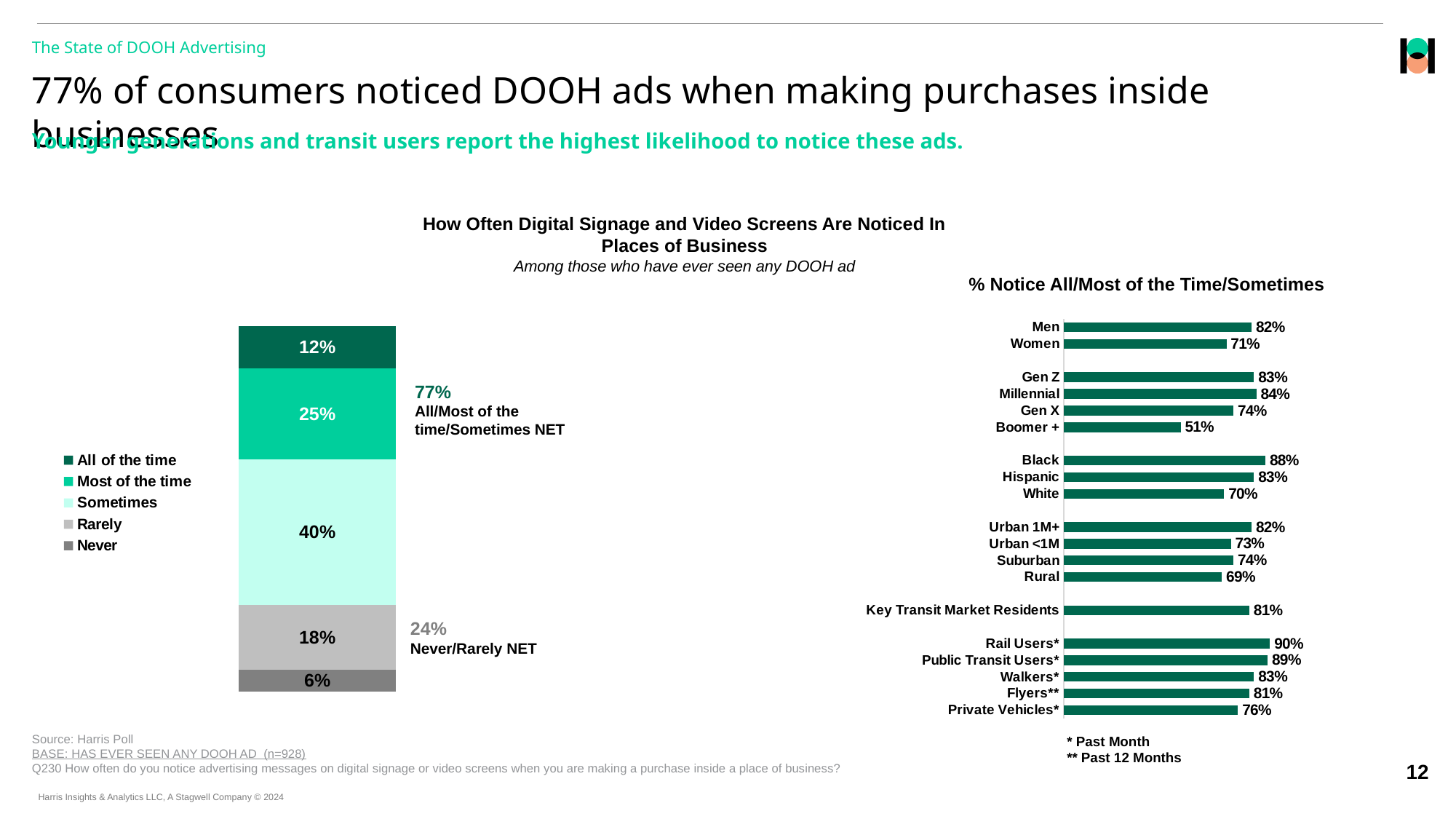
In the '% Notice All/Most of the Time/Sometimes' chart, what is the value for Rail Users*? 90% What kind of chart is the '% Notice All/Most of the Time/Sometimes' chart? Bar chart In the '% Notice All/Most of the Time/Sometimes' chart, what is the difference between Men and Women? 11% In the stacked chart 'How Often Digital Signage and Video Screens Are Noticed In Places of Business', what is the value for Never? 6% In the stacked chart 'How Often Digital Signage and Video Screens Are Noticed In Places of Business', what is the combined total of Rarely and Never? 24% In the '% Notice All/Most of the Time/Sometimes' chart, how many categories are plotted? 19 In the '% Notice All/Most of the Time/Sometimes' chart, which category has the highest value? Rail Users* In the '% Notice All/Most of the Time/Sometimes' chart, which is larger, Urban 1M+ or Rural? Urban 1M+ In the '% Notice All/Most of the Time/Sometimes' chart, which category has the lowest value? Boomer + In the stacked chart 'How Often Digital Signage and Video Screens Are Noticed In Places of Business', what is the value for Sometimes? 40% How many series does the legend of the stacked chart 'How Often Digital Signage and Video Screens Are Noticed In Places of Business' list? 5 In the '% Notice All/Most of the Time/Sometimes' chart, what is the value for Boomer +? 51%